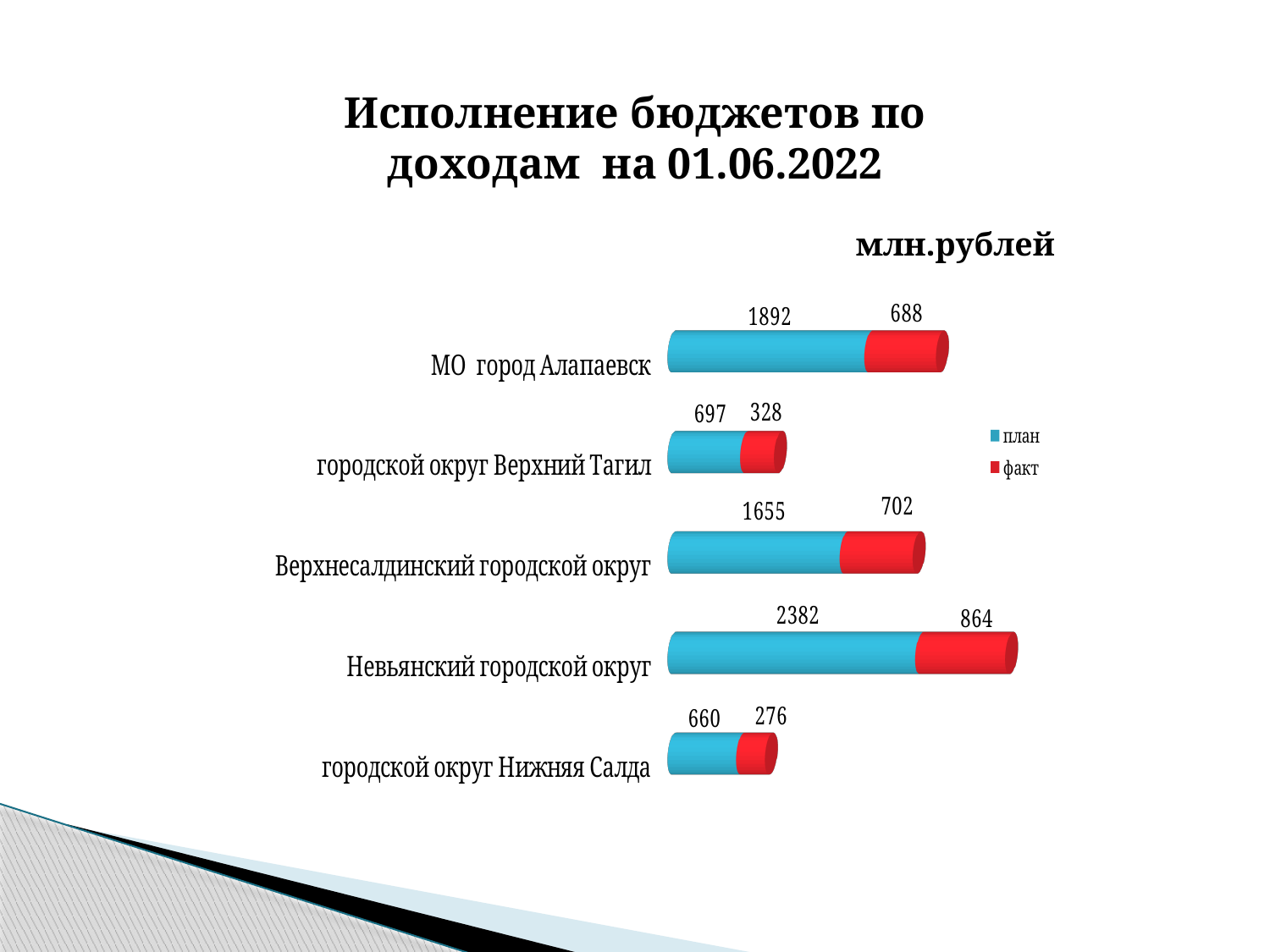
What is the план value for Невьянский городской округ? 2382 Which is larger: the факт value for Верхнесалдинский городской округ or the факт value for МО город Алапаевск? Верхнесалдинский городской округ How many categories are shown in the chart? 5 What is the difference between the план and факт values for МО город Алапаевск? 1204 What is the план value for городской округ Нижняя Салда? 660 What is the total of the stacked bar for городской округ Верхний Тагил? 1025 What kind of chart is shown on the slide? Stacked bar chart Which category has the highest факт value? Невьянский городской округ What unit is stated above the chart? млн.рублей How many series does the legend list? 2 What is the факт value for городской округ Верхний Тагил? 328 Which category has the lowest план value? городской округ Нижняя Салда